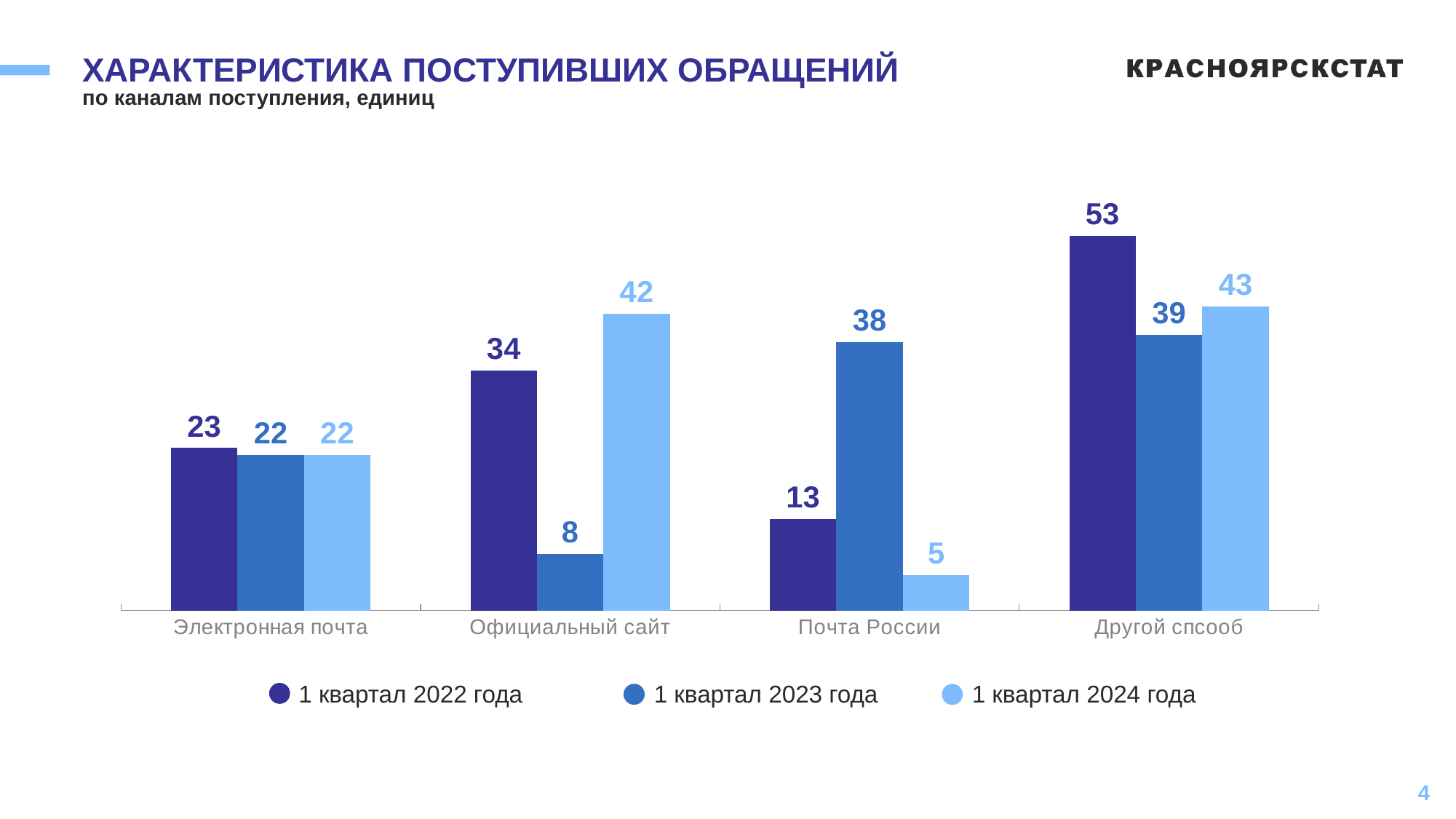
What is the difference between the 1 квартал 2023 года and 1 квартал 2022 года values for Почта России? 25 What is the value for Другой спсооб in 1 квартал 2022 года? 53 How many categories are shown on the x axis? 4 How many series does the legend list? 3 What is the subtitle printed under the chart title? по каналам поступления, единиц What is the difference between the 1 квартал 2022 года and 1 квартал 2024 года values for Другой спсооб? 10 What kind of chart is shown on the slide? Bar chart Which category has the highest value in 1 квартал 2022 года? Другой спсооб Which category has the lowest value in 1 квартал 2024 года? Почта России Which is larger for Официальный сайт: the value for 1 квартал 2022 года or 1 квартал 2023 года? 1 квартал 2022 года What is the value for Почта России in 1 квартал 2023 года? 38 What is the value for Официальный сайт in 1 квартал 2024 года? 42